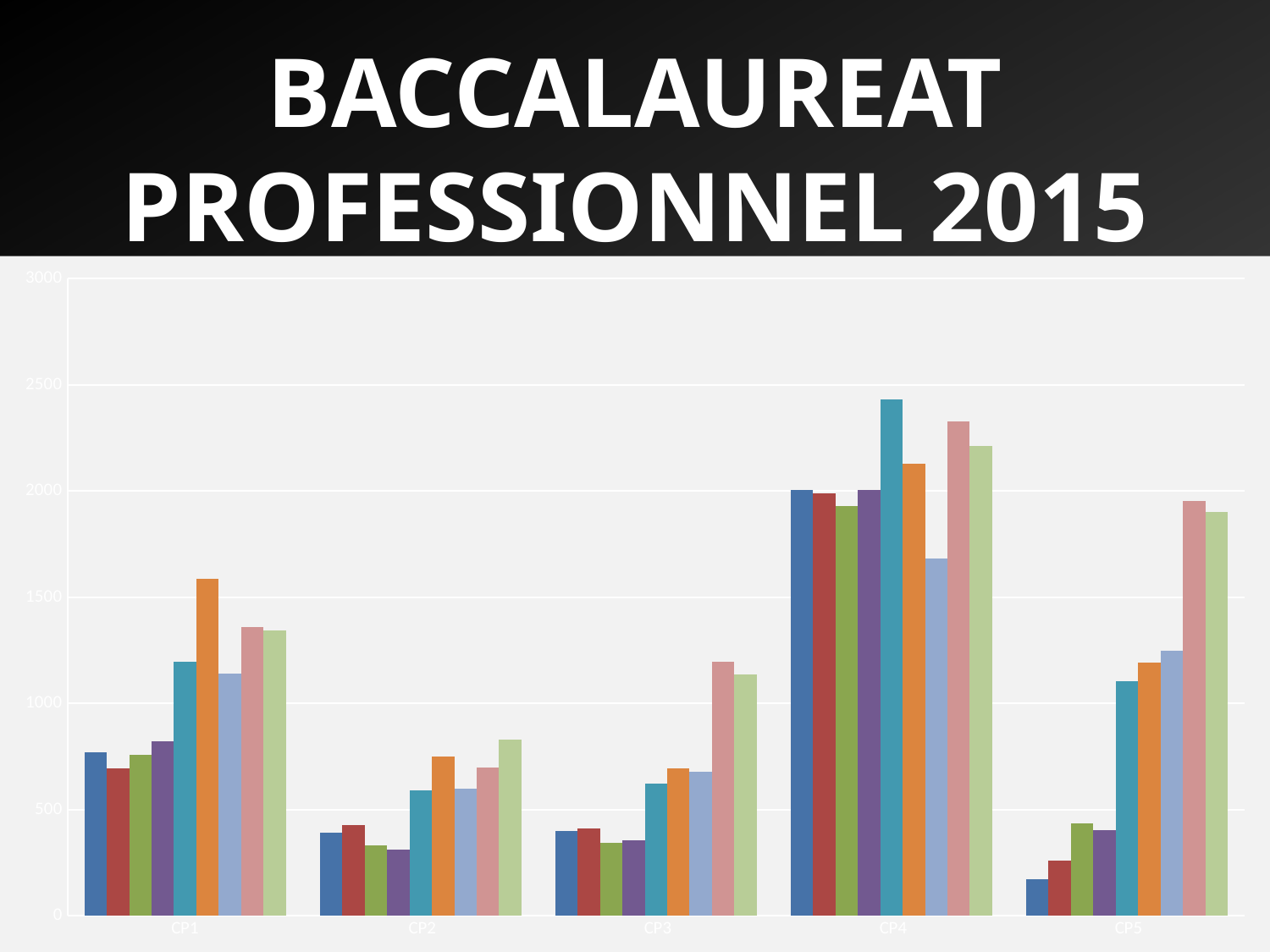
Is the value of the orange bar in CP1 greater or less than 1500? greater Is the value of the pink bar in CP5 greater or less than 1500? greater Is the value of the dark blue bar in CP1 greater or less than 1000? less Which category on the x axis contains the shortest bar in the chart? CP5 What kind of chart is shown on the slide? bar chart What is the title of the slide containing the chart? BACCALAUREAT PROFESSIONNEL 2015 Which is larger, the orange bar in CP4 or the orange bar in CP1? CP4 What is the highest value shown on the y axis of the chart? 3000 Which category on the x axis contains the tallest bar in the chart? CP4 How many categories are shown on the x axis of the chart? 5